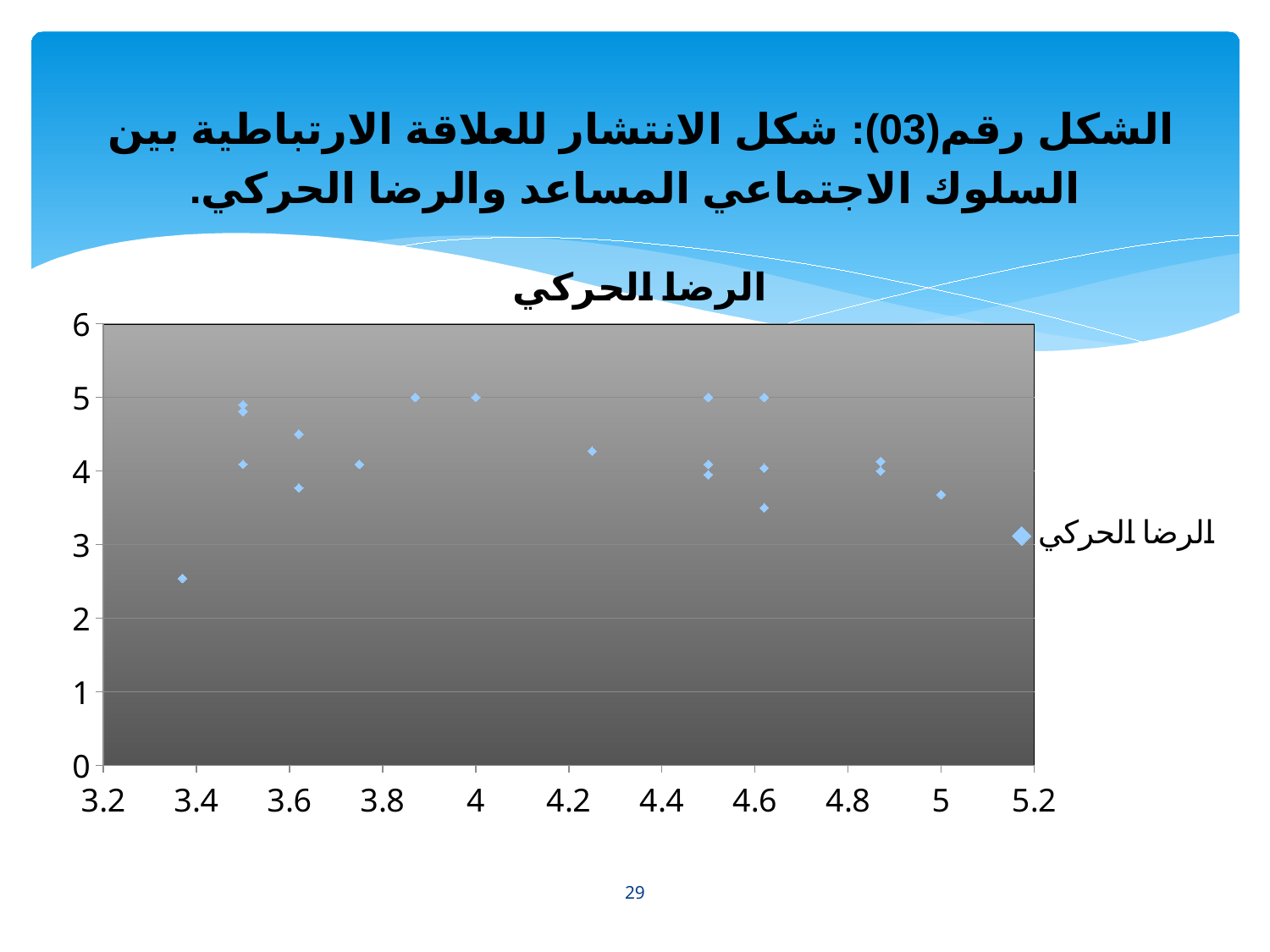
Is the y value of the point at x = 3.8 greater or less than 3? greater Is the y value of the point at x = 5 greater or less than 4? less Is the y value of the point at x = 4.2 greater or less than 5? less How many series does the legend list? 1 What is the legend entry shown to the right of the chart? الرضا الحركي What is the title of the chart? الرضا الحركي What kind of chart is shown on the slide? scatter chart Which has the larger y value: the point at x = 3.4 or the point at x = 4? the point at x = 4